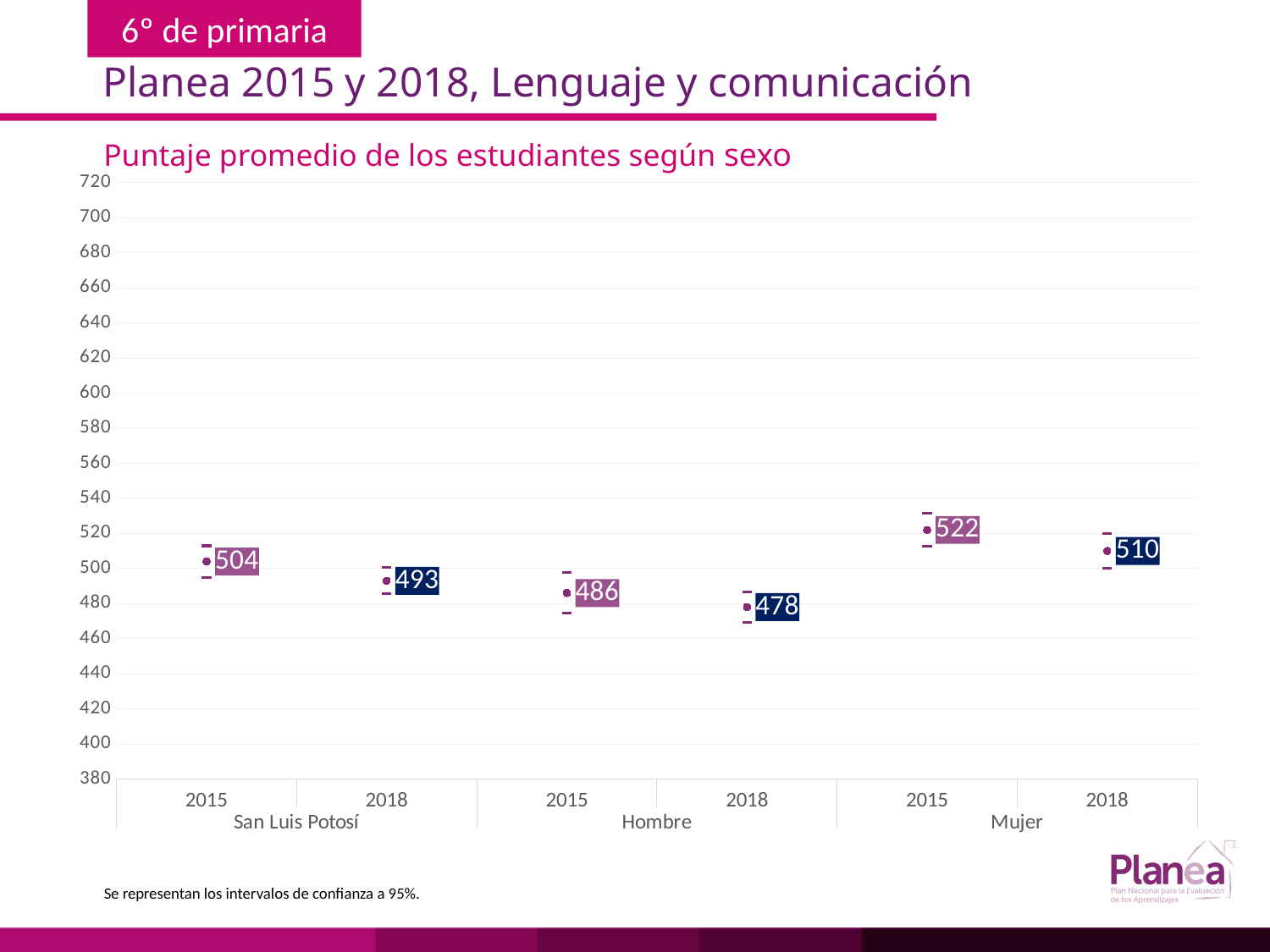
Which group and year has the highest average score? Mujer 2015 Which is larger, the Hombre score in 2015 or the San Luis Potosí score in 2018? San Luis Potosí 2018 What is the difference between the Mujer and Hombre scores in 2018? 32 Which group and year has the lowest average score? Hombre 2018 What is the difference between the Mujer score in 2015 and in 2018? 12 From 2015 to 2018, did the Hombre score rise or fall? fall How many data points are plotted on the chart? 6 What is the average score for San Luis Potosí in 2018? 493 What is the average score for Mujer in 2015? 522 What is the average score for Hombre in 2018? 478 What is the average score for San Luis Potosí in 2015? 504 What is the subtitle of the chart? Puntaje promedio de los estudiantes según sexo